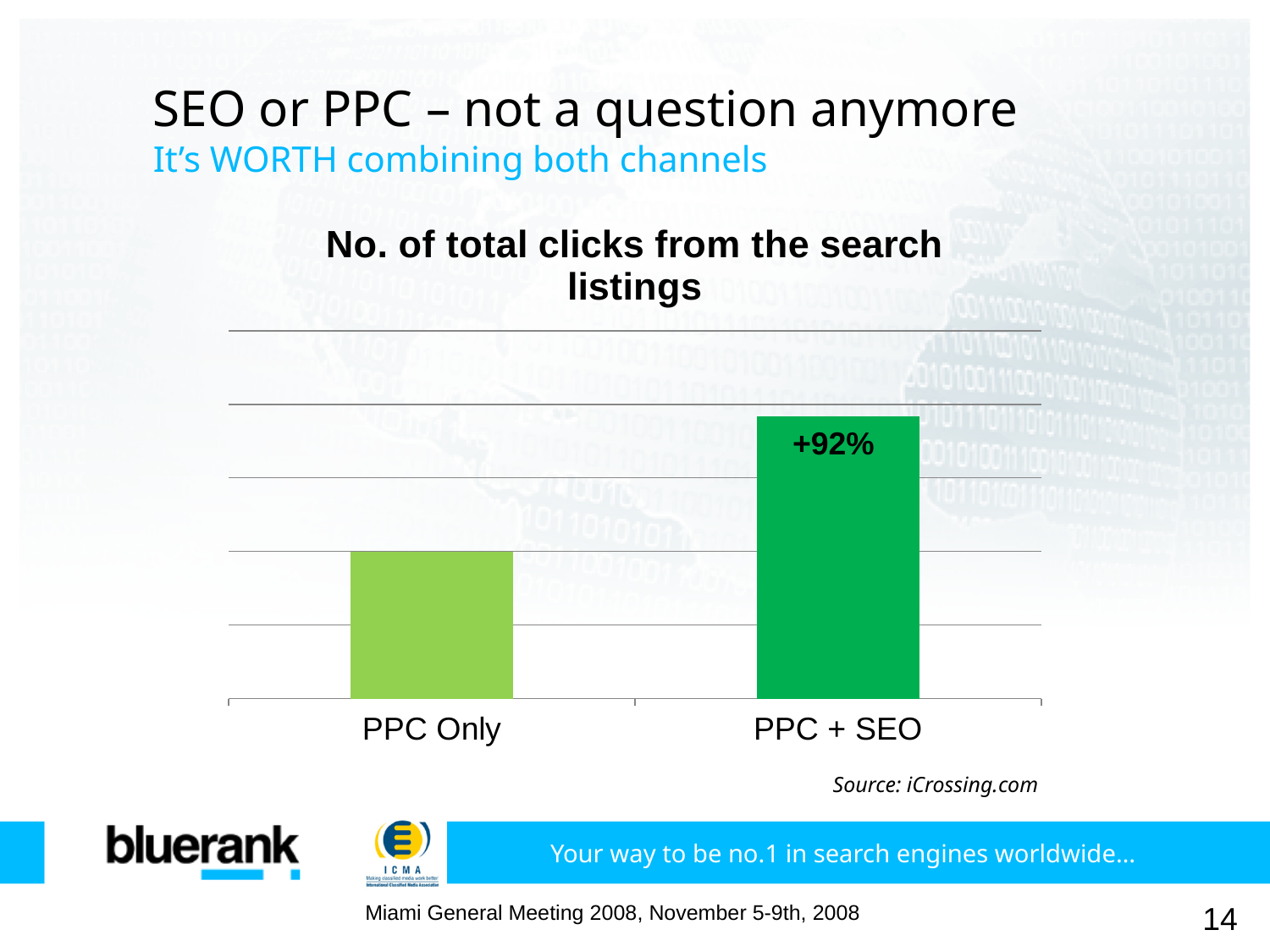
What label is printed on the PPC + SEO bar? +92% Which category has the highest number of total clicks from the search listings? PPC + SEO How many categories are plotted in the chart? 2 By what percentage does the PPC + SEO bar exceed PPC Only, according to the label on the chart? +92% What kind of chart is shown on the slide? bar chart What is the source cited below the chart? iCrossing.com Which is larger, the value for PPC Only or the value for PPC + SEO? PPC + SEO What is the title of the chart? No. of total clicks from the search listings Which category has the lowest number of total clicks from the search listings? PPC Only